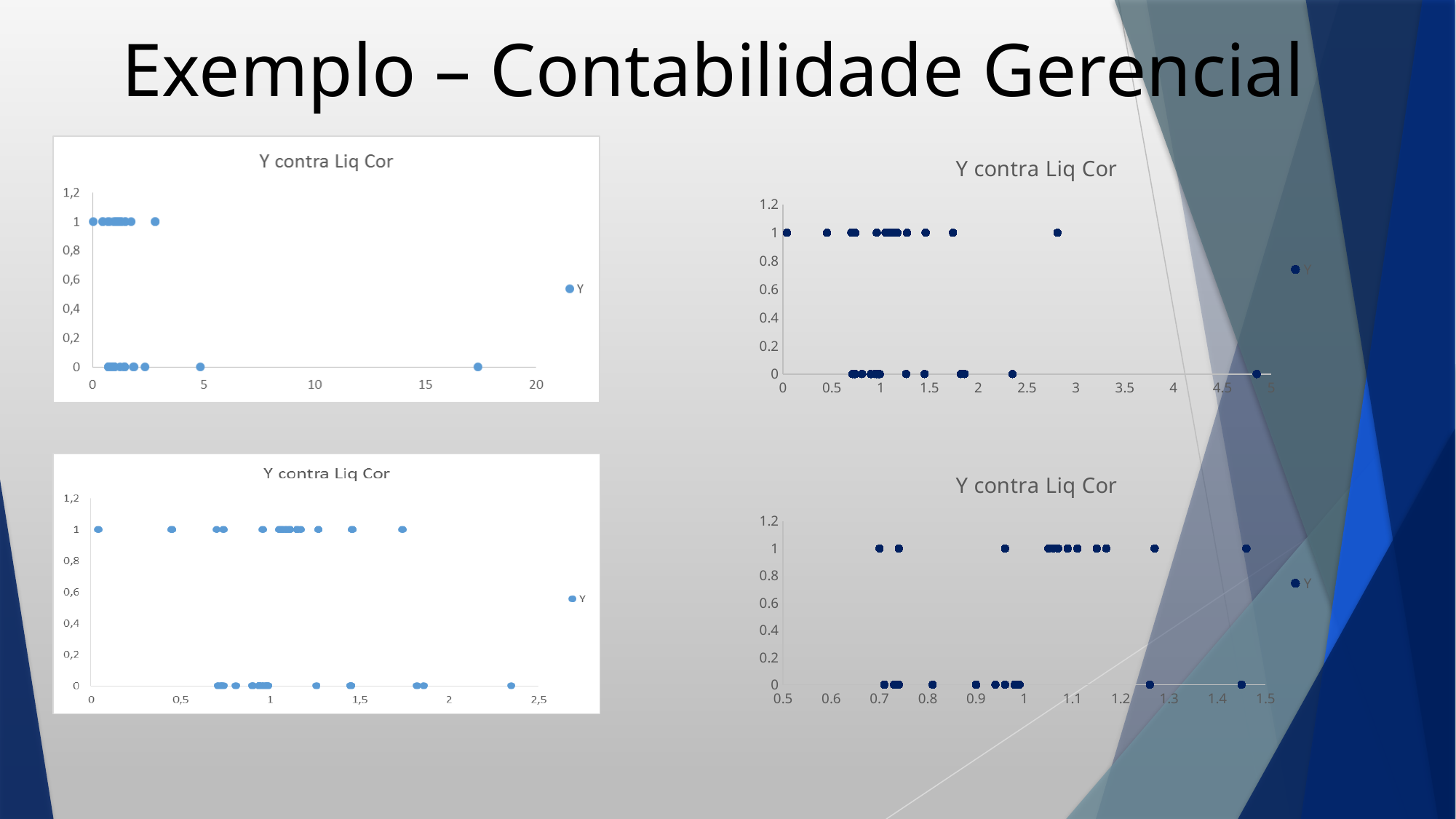
What kind of chart is the top-left chart on the slide? Scatter chart In the bottom-right chart, what is the smallest value shown on the x axis? 0.5 In the bottom-left chart, is the x value of the rightmost point at y = 0 greater or less than 2? greater In the top-right chart, is the x value of the rightmost point at y = 1 greater or less than 2.5? greater What is the highest value shown on the y axis of the bottom-left chart? 1,2 In the top-left chart, what is the largest value shown on the x axis? 20 In the top-left chart, is the x value of the rightmost point at y = 0 greater or less than 15? greater What is the name of the series shown in the legend of the bottom-right chart? Y In the top-right chart, which two y values do all the plotted points take? 0 and 1 How many series does the legend of the bottom-left chart list? 1 What is the title of the top-right chart? Y contra Liq Cor